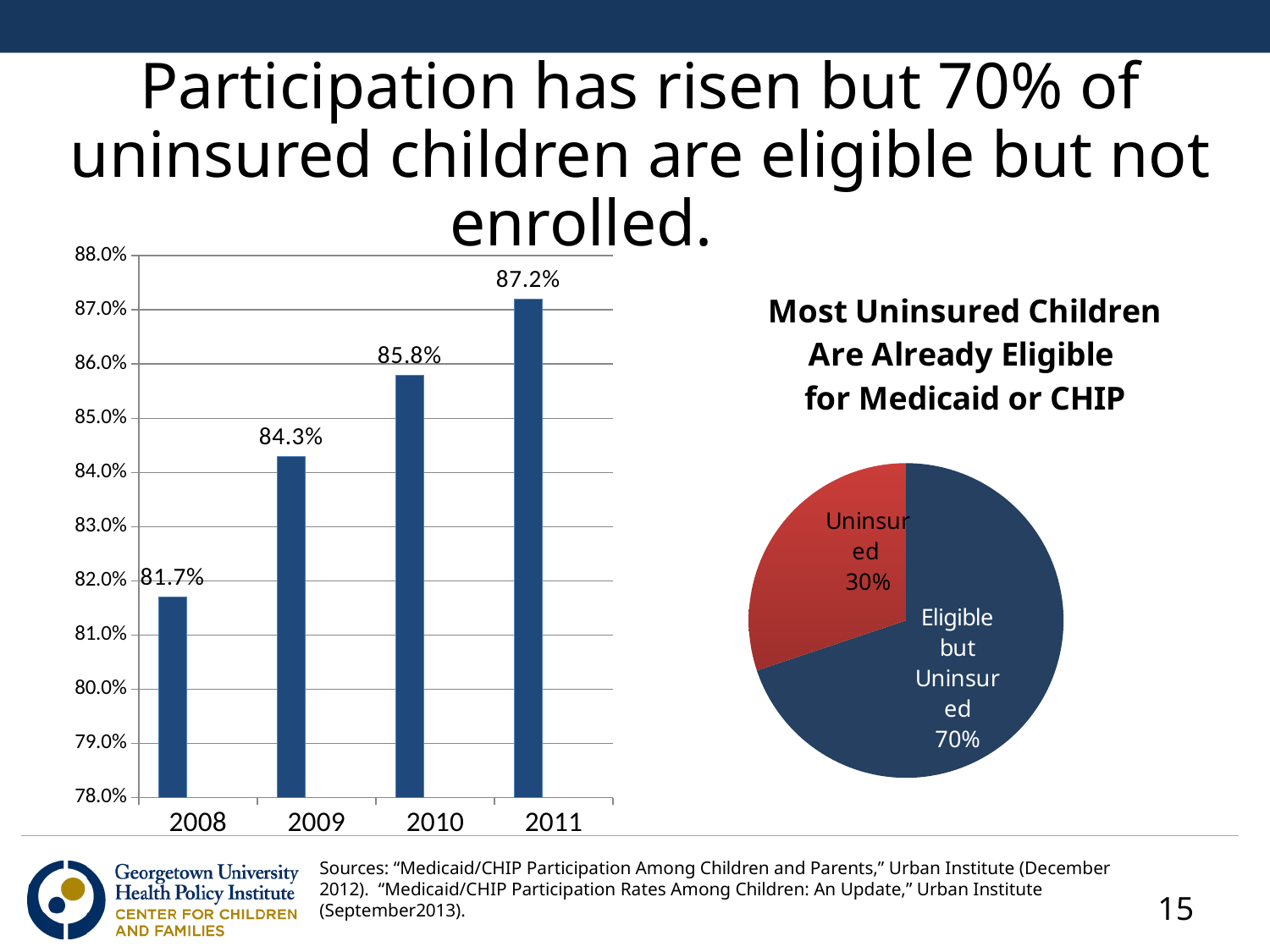
In the bar chart on the left, which year has the highest value? 2011 In the bar chart on the left, which year has the lowest value? 2008 What kind of chart is on the left side of the slide? bar chart In the bar chart on the left, what is the difference between the 2011 and 2008 values? 5.5% In the bar chart on the left, do the values rise or fall from 2008 to 2011? rise In the bar chart on the left, which is larger, the value for 2009 or the value for 2010? 2010 In the pie chart on the right, how many slices are there? 2 In the bar chart on the left, what is the difference between the 2010 and 2009 values? 1.5% In the pie chart titled 'Most Uninsured Children Are Already Eligible for Medicaid or CHIP', what share is 'Eligible but Uninsured'? 70% In the bar chart on the left, how many years are shown? 4 In the bar chart on the left, what is the value for 2008? 81.7% In the bar chart on the left, what is the participation rate for 2011? 87.2%